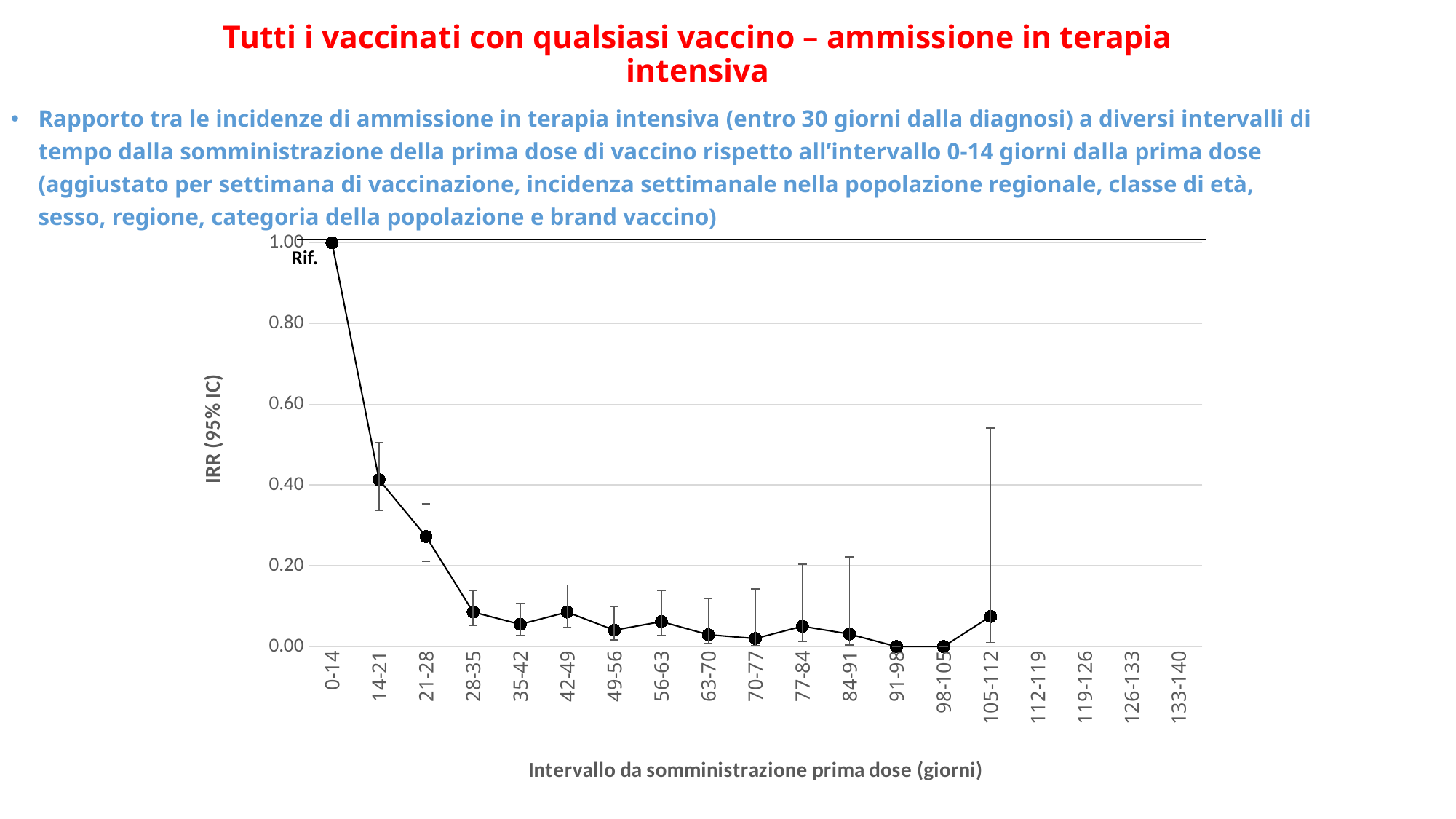
How many interval labels are shown on the x axis? 19 Is the IRR value for the 28-35 interval greater or less than 0.20? less Do the IRR values rise or fall from the 0-14 interval to the 28-35 interval? fall Is the IRR value for the 21-28 interval greater or less than 0.20? greater What kind of chart is shown on the slide? line chart Which interval has the highest IRR value? 0-14 Is the IRR value for the 105-112 interval greater or less than 0.20? less What is the IRR value for the 0-14 day interval? 1.00 What is the title of the y axis? IRR (95% IC) What label is printed next to the first data point at the 0-14 interval? Rif. Which has the larger IRR value, the 14-21 interval or the 21-28 interval? 14-21